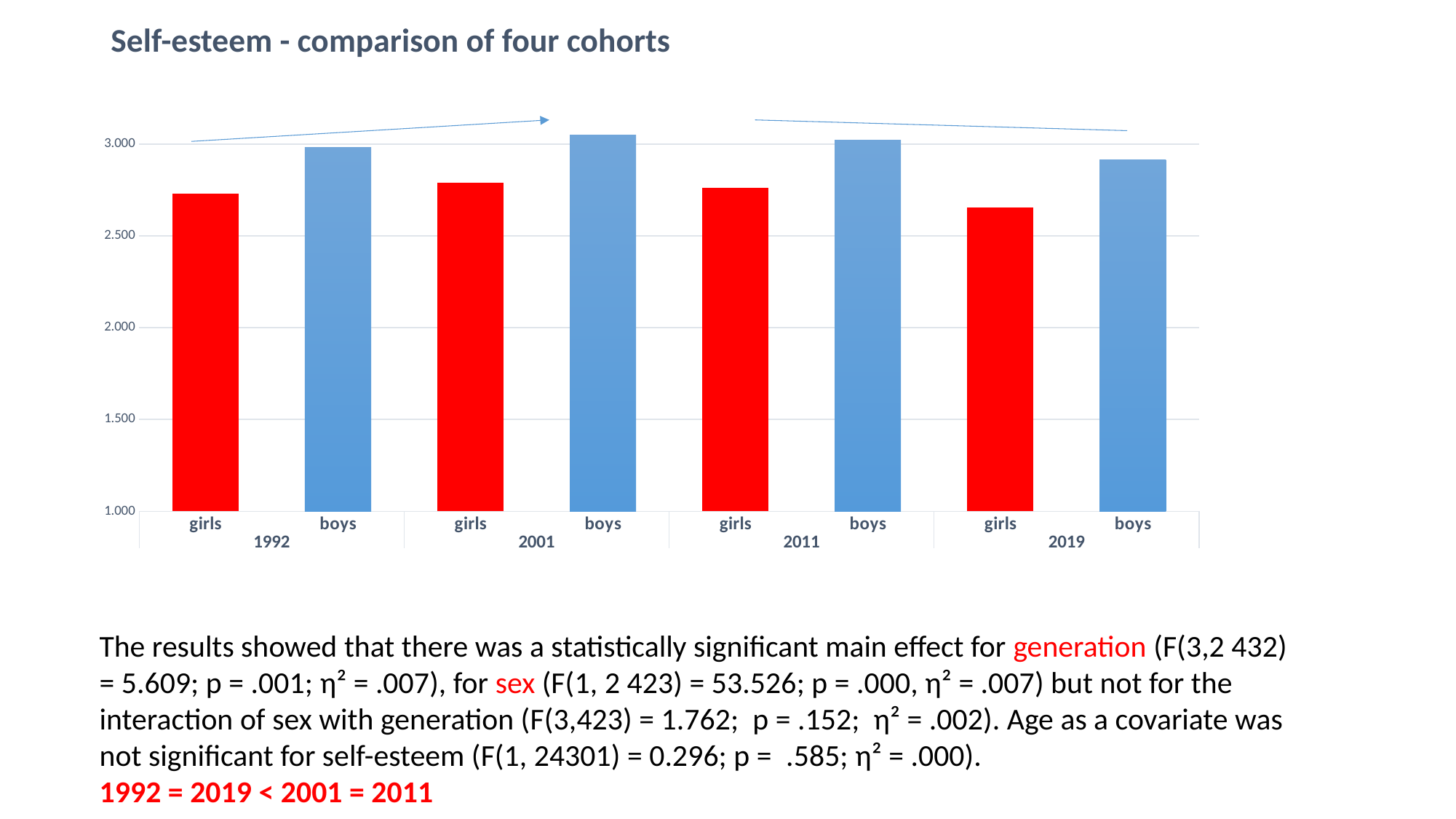
Is the value for girls in 2019 greater or less than 2.500? greater Which is larger, the value for girls in 2001 or girls in 2019? girls in 2001 Do the values for girls rise or fall from 2011 to 2019? fall What kind of chart is shown on the slide? bar chart How many cohort years are shown on the x axis? 4 What is the title of the chart? Self-esteem - comparison of four cohorts Which bar is the lowest in the chart? girls 2019 How many bars are plotted in the chart? 8 Is the value for boys in 2001 greater or less than 3.000? greater Which is larger, the value for boys in 1992 or girls in 1992? boys in 1992 Is the value for girls in 1992 greater or less than 3.000? less What colour are the bars for girls? red